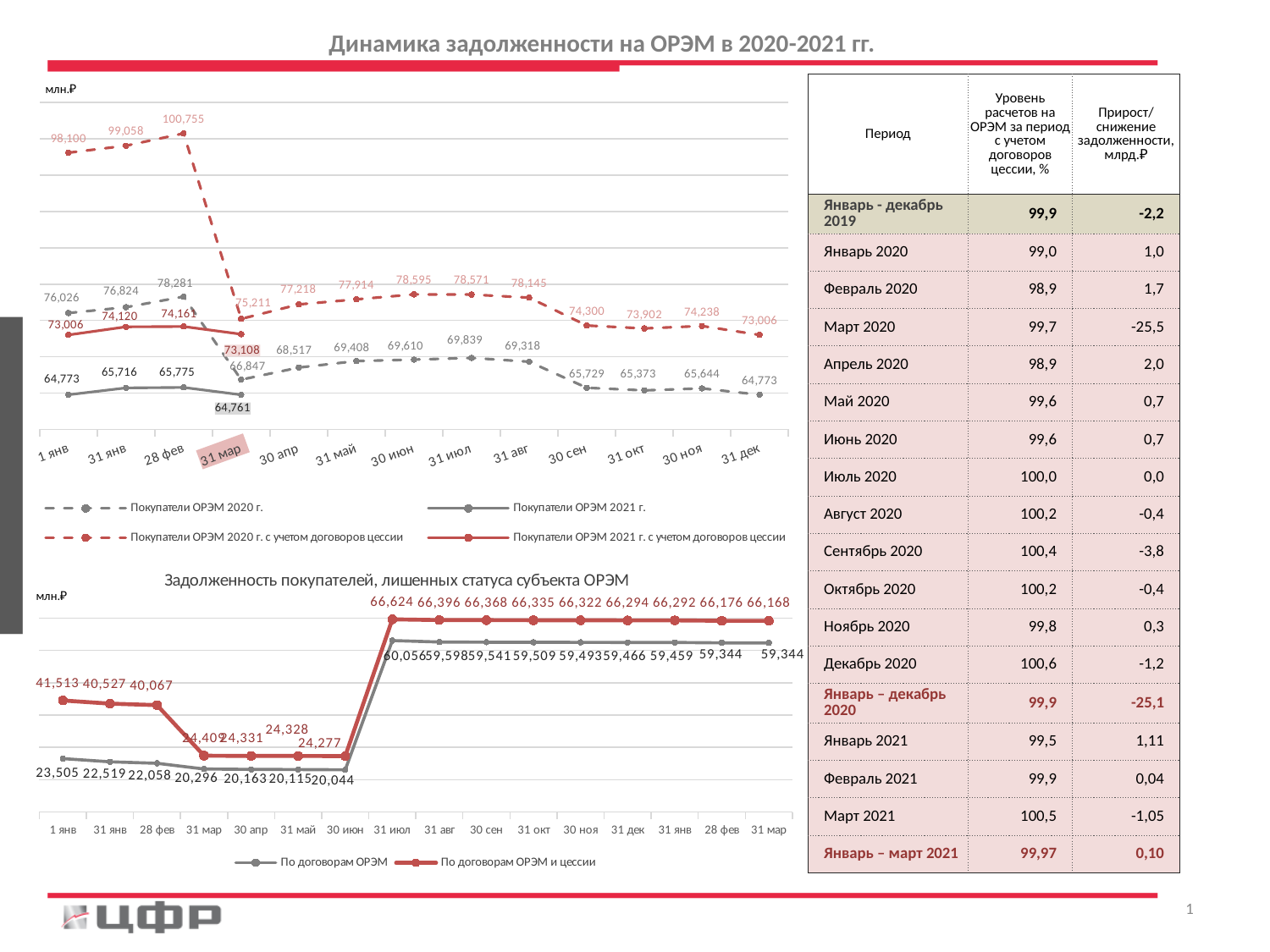
On the bottom chart (Задолженность покупателей, лишенных статуса субъекта ОРЭМ), which series has the larger value at 1 янв? По договорам ОРЭМ и цессии On the top chart (Динамика задолженности на ОРЭМ в 2020-2021 гг.), what is the value for Покупатели ОРЭМ 2020 г. at 31 июл? 69,839 On the bottom chart (Задолженность покупателей, лишенных статуса субъекта ОРЭМ), what is the value for По договорам ОРЭМ и цессии at 31 июл? 66,624 On the top chart (Динамика задолженности на ОРЭМ в 2020-2021 гг.), at which date does the series Покупатели ОРЭМ 2020 г. с учетом договоров цессии reach its highest value? 28 фев On the bottom chart (Задолженность покупателей, лишенных статуса субъекта ОРЭМ), what is the difference between По договорам ОРЭМ и цессии and По договорам ОРЭМ at 31 июл? 6,568 On the top chart (Динамика задолженности на ОРЭМ в 2020-2021 гг.), what is the value for Покупатели ОРЭМ 2020 г. с учетом договоров цессии at 28 фев? 100,755 How many series does the legend of the top chart (Динамика задолженности на ОРЭМ в 2020-2021 гг.) list? 4 What kind of chart is the bottom chart (Задолженность покупателей, лишенных статуса субъекта ОРЭМ)? Line chart How many dates are shown on the x axis of the bottom chart (Задолженность покупателей, лишенных статуса субъекта ОРЭМ)? 16 On the bottom chart (Задолженность покупателей, лишенных статуса субъекта ОРЭМ), at which date is the value for По договорам ОРЭМ lowest? 30 июн On the top chart (Динамика задолженности на ОРЭМ в 2020-2021 гг.), what is the value for Покупатели ОРЭМ 2021 г. at 31 мар? 64,761 On the top chart (Динамика задолженности на ОРЭМ в 2020-2021 гг.), by how much did Покупатели ОРЭМ 2020 г. с учетом договоров цессии fall from 28 фев to 31 мар? 25,544